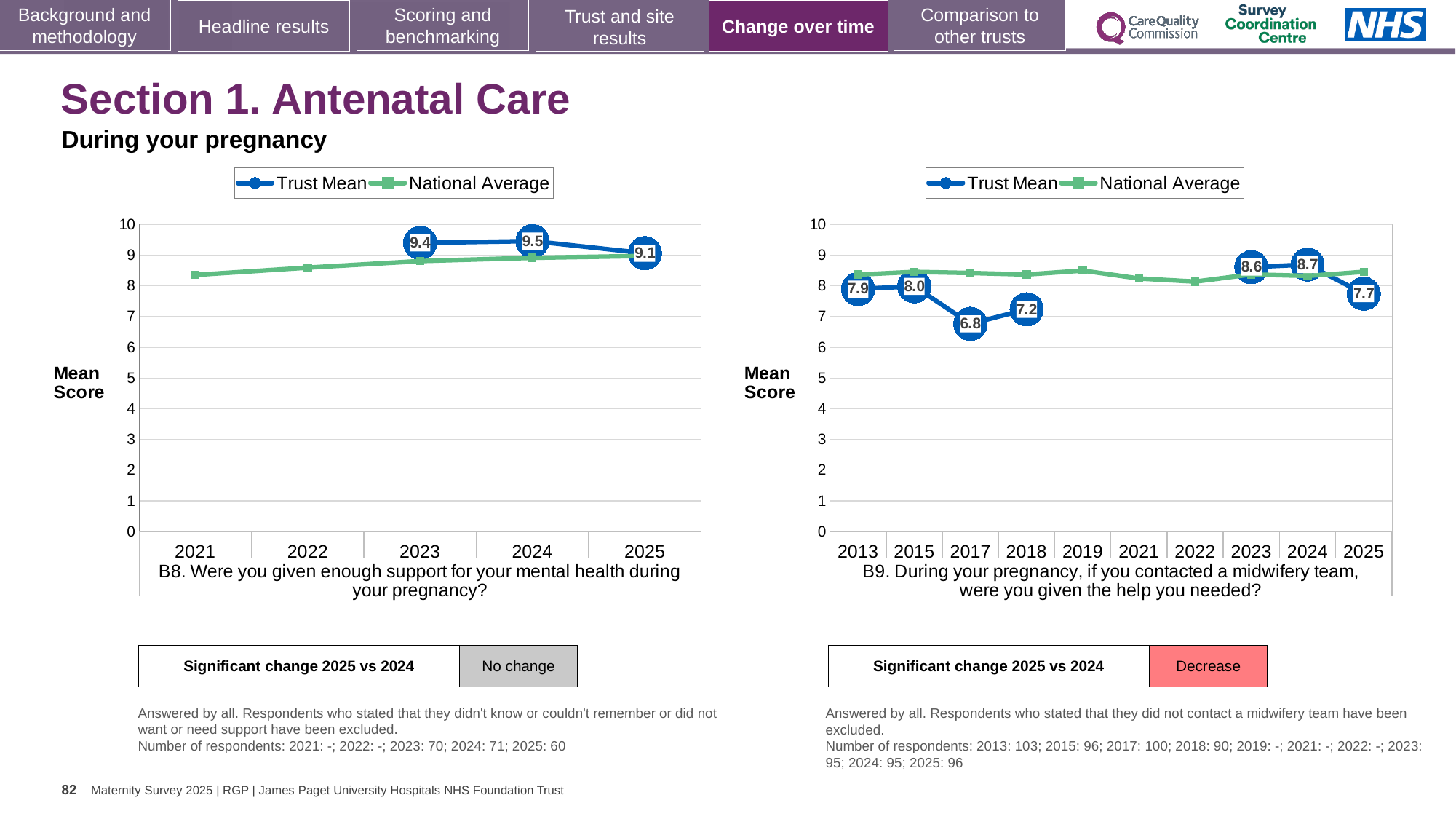
In the B8 chart on the left, what is the difference between the Trust Mean for 2024 and 2025? 0.4 What kind of chart is the B9 chart on the right? Line chart In the B9 chart on the right, which year has the lowest Trust Mean? 2017 In the B9 chart on the right, which is larger, the Trust Mean for 2013 or for 2025? 2013 In the B8 chart on the left, which year has the highest Trust Mean? 2024 In the B9 chart on the right, what is the Trust Mean for 2024? 8.7 In the B8 chart on the left, how many series does the legend list? 2 In the B9 chart on the right, is the National Average for 2019 greater or less than 8? greater In the B9 chart on the right, how many years are shown on the x axis? 10 In the B9 chart on the right, what is the Trust Mean for 2017? 6.8 In the B8 chart on the left, what is the Trust Mean for 2025? 9.1 In the B8 chart on the left, what is the Trust Mean for 2024? 9.5